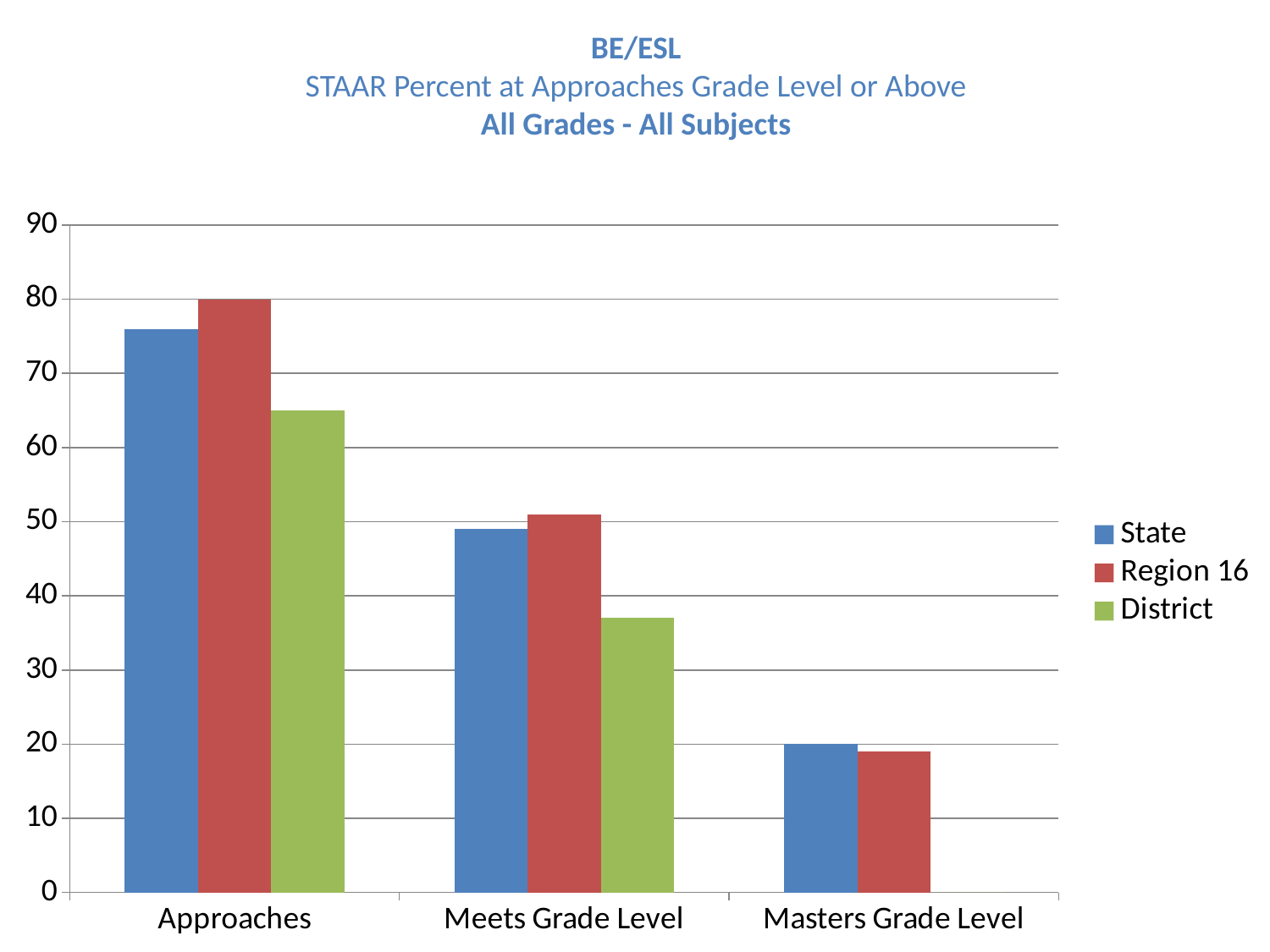
How many categories are shown on the x axis? 3 Which series has the highest value in the Approaches category? Region 16 Which series has the lowest value in the Meets Grade Level category? District How many series does the legend list? 3 Which series is shown in green in the legend? District Is the value for State in the Approaches category greater or less than 70? greater Do the State values rise or fall from Approaches to Masters Grade Level? fall What kind of chart is shown on the slide? bar chart Is the value for District in the Approaches category greater or less than 60? greater Which is larger in the Meets Grade Level category, State or District? State Is the value for District in the Meets Grade Level category greater or less than 40? less